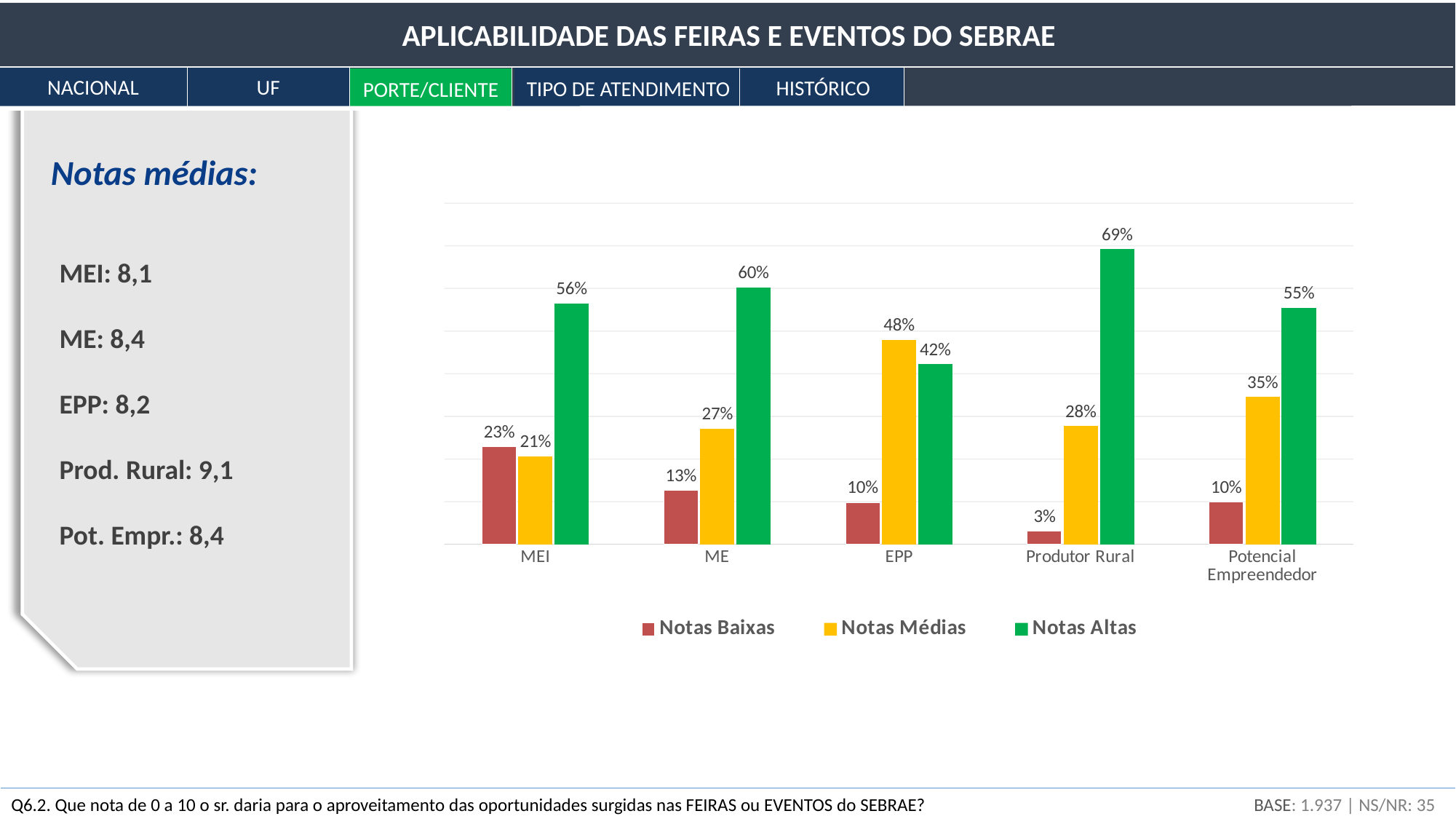
Which category has the highest Notas Altas value? Produtor Rural How many series does the legend list? 3 What is the difference between Notas Altas for ME and Notas Altas for EPP? 18% What is the value of Notas Baixas for MEI? 23% What kind of chart is shown? Bar chart Which colour represents Notas Altas in the legend? Green What is the value of Notas Altas for Produtor Rural? 69% Which category has the lowest Notas Baixas value? Produtor Rural What is the value of Notas Médias for Potencial Empreendedor? 35% What is the value of Notas Médias for EPP? 48% Which is larger for EPP: Notas Médias or Notas Altas? Notas Médias How many categories are shown on the x axis? 5